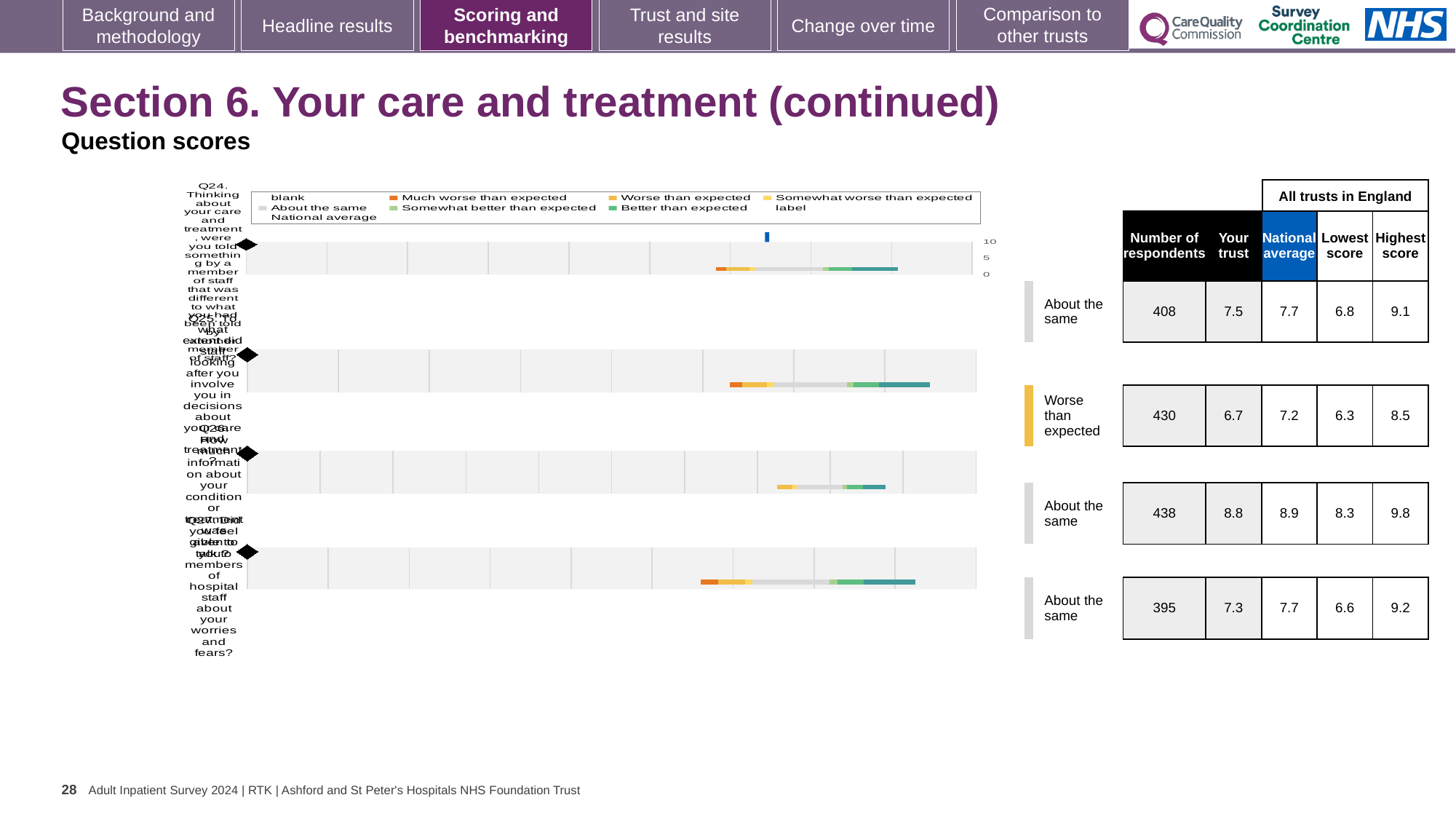
For the Q25 chart (second row), which is larger: the 'Your trust' score or the national average? National average How many of the four question rows are labelled 'About the same'? 3 For the Q27 chart (fourth row), what is the highest score among all trusts in England? 9.2 Which question row has the highest 'Your trust' score? Q26 What benchmark category is shown next to the Q25 chart (second row)? Worse than expected For the Q26 chart (third row), how many respondents are listed? 438 How many question charts (Q24 to Q27) are shown on the slide? 4 For the Q25 chart (second row), what is the national average score? 7.2 For the Q24 chart (first row), what is the 'Your trust' score shown in the table? 7.5 Which question row has the lowest number of respondents? Q27 What kind of chart is used to show the question scores on this slide? Bar chart For the Q26 chart (third row), what is the difference between the highest score and the lowest score? 1.5